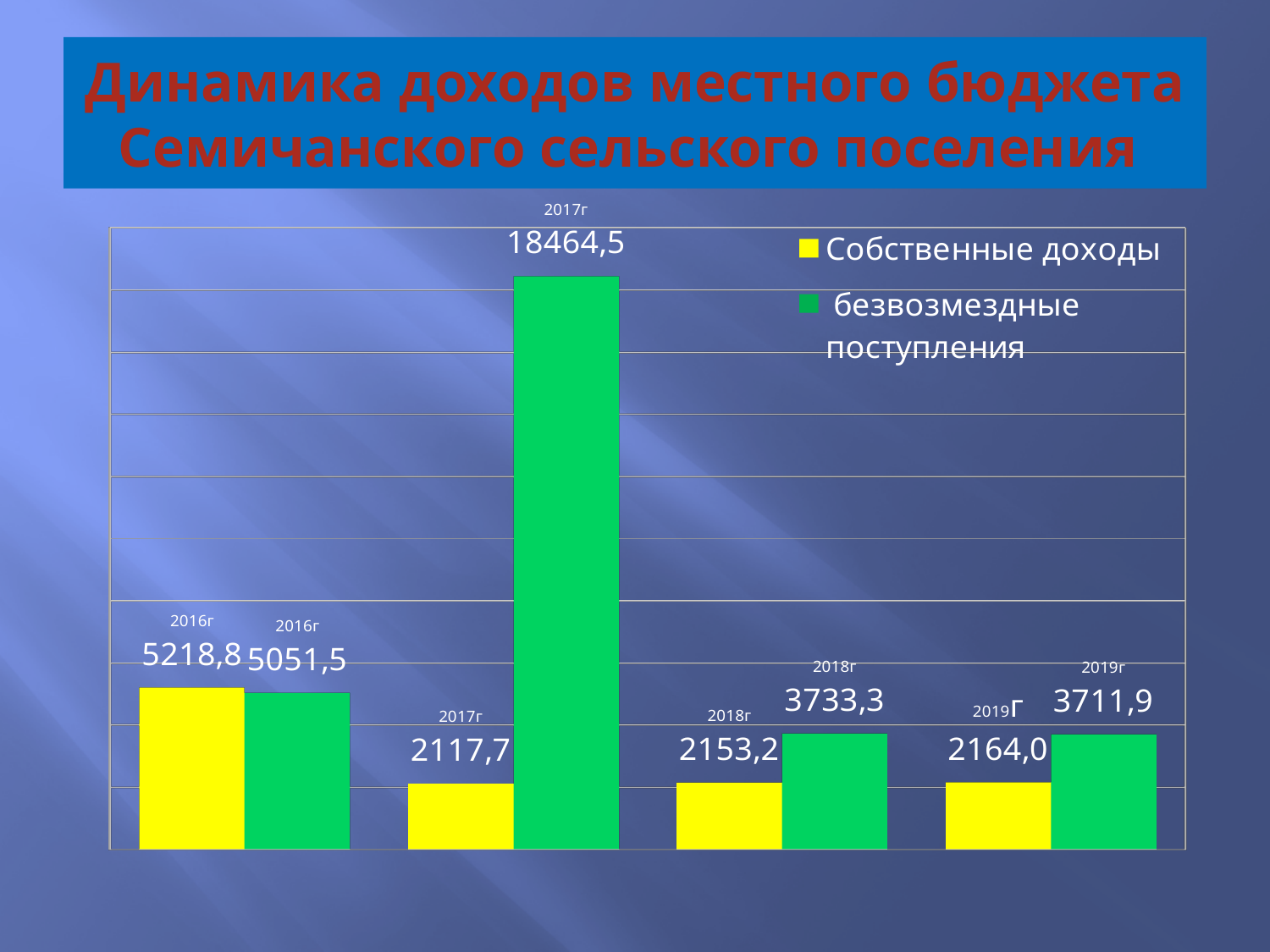
Which is larger in 2016г: Собственные доходы or безвозмездные поступления? Собственные доходы What is the value of Собственные доходы for 2019г? 2164,0 In which year is безвозмездные поступления highest? 2017г What is the difference between безвозмездные поступления and Собственные доходы in 2017г? 16346,8 How many series does the legend list? 2 How many years are shown on the chart? 4 Which colour represents Собственные доходы in the chart? yellow What is the value of безвозмездные поступления for 2018г? 3733,3 What is the value of безвозмездные поступления for 2017г? 18464,5 In which year is Собственные доходы lowest? 2017г What is the value of Собственные доходы for 2016г? 5218,8 What kind of chart is shown on the slide? bar chart